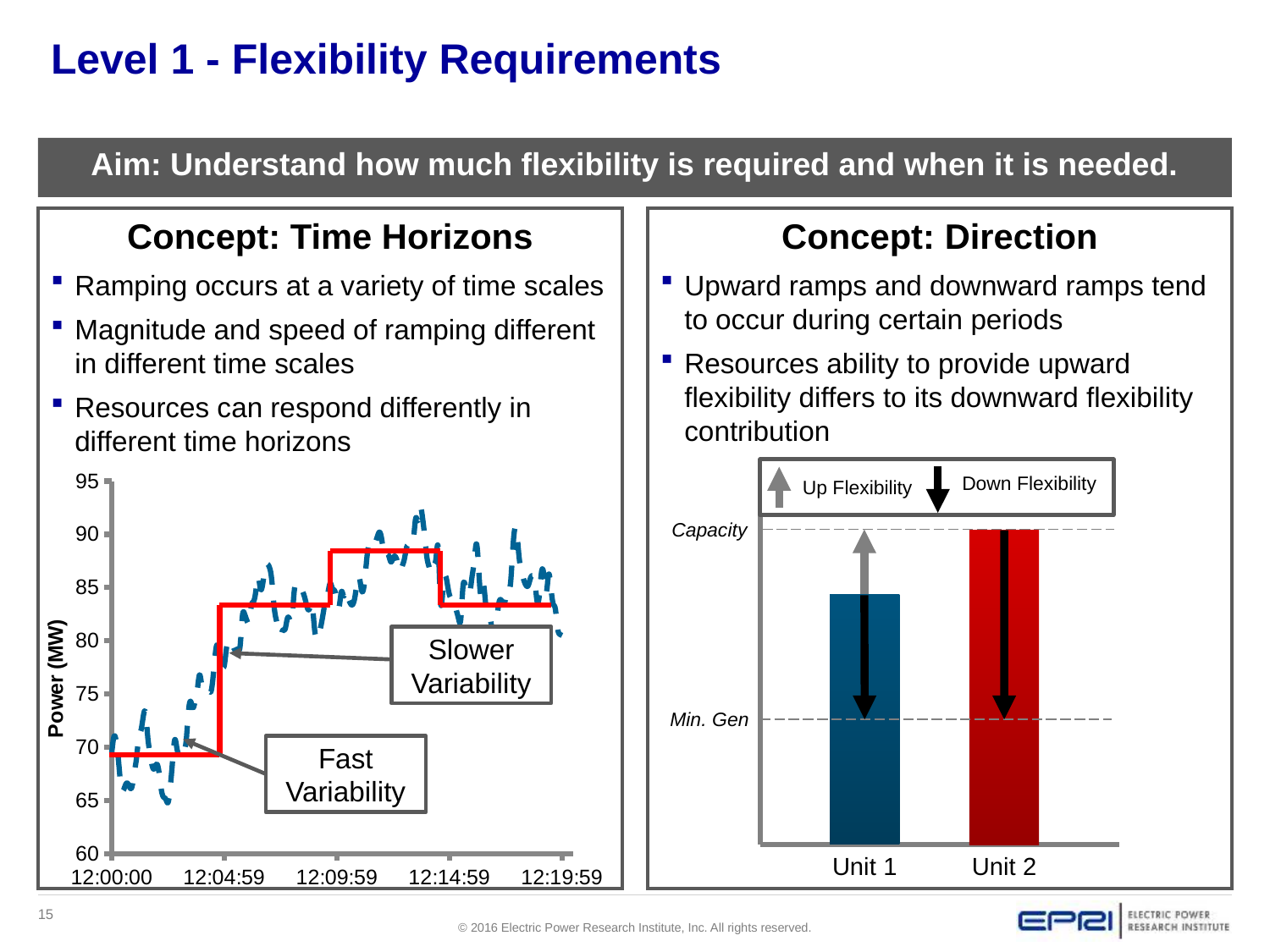
What kind of chart is the chart on the right of the slide showing Unit 1 and Unit 2? bar chart In the chart on the left, is the value of the red step line between 12:09:59 and 12:14:59 greater or less than 85? greater In the chart on the left, what is the label of the y axis? Power (MW) In the chart on the right, how many units (categories) are plotted? 2 What kind of chart is the chart on the left of the slide (Power (MW) over time)? line chart In the chart on the right, how many entries does the legend list? 2 In the chart on the right, which bar is taller, Unit 1 or Unit 2? Unit 2 In the chart on the left, is the value of the red step line between 12:04:59 and 12:09:59 greater or less than 80? greater In the chart on the left, does the red step line rise or fall between 12:00:00 and 12:09:59? rises In the chart on the right, which unit has the taller bar? Unit 2 In the chart on the right, which unit has the shorter bar? Unit 1 In the chart on the right, which unit's bar reaches the Capacity line? Unit 2